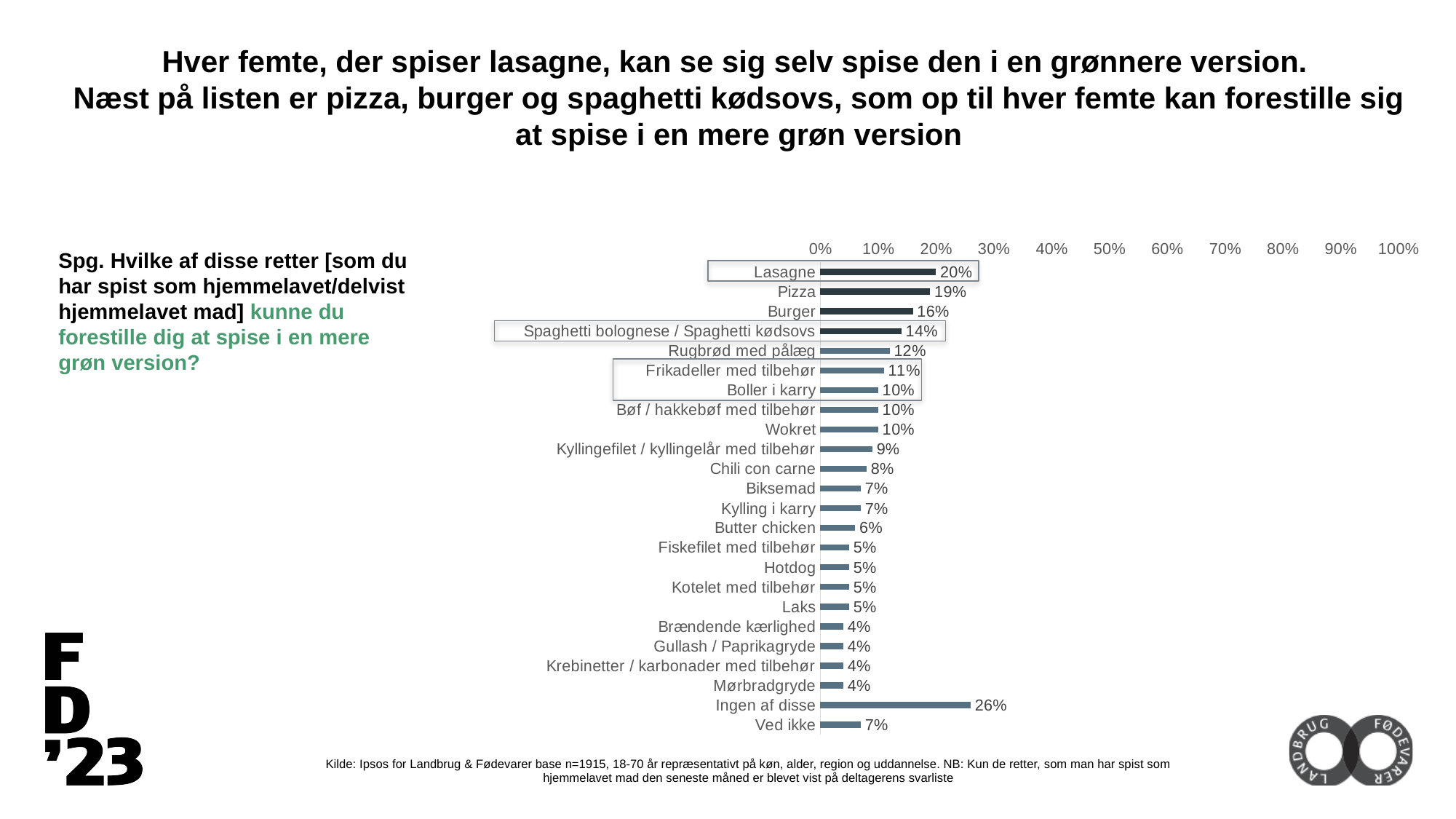
What is the value for Pizza? 19% Which is larger, the value for Rugbrød med pålæg or the value for Chili con carne? Rugbrød med pålæg Is the value for Ingen af disse greater or less than 20%? greater What is the value for Ved ikke? 7% What is the value for Ingen af disse? 26% Which category has the highest value in the chart? Ingen af disse What is the value for Spaghetti bolognese / Spaghetti kødsovs? 14% What kind of chart is shown on the slide? bar chart What is the difference between the values for Lasagne and Burger? 4% What is the difference between the values for Ingen af disse and Lasagne? 6% How many categories are shown in the chart? 24 What is the value for Lasagne? 20%